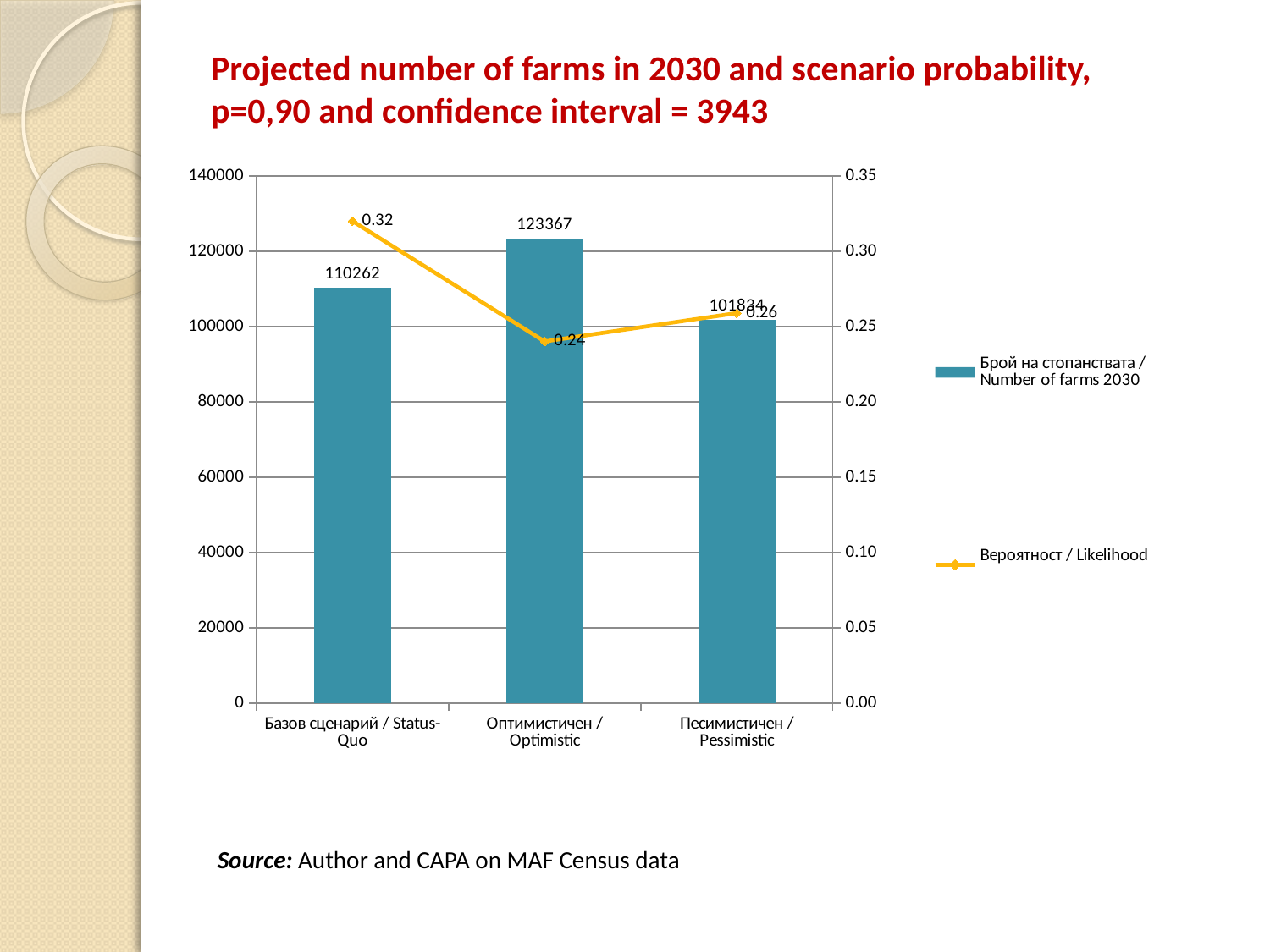
What is the difference in projected number of farms between the Optimistic and Status-Quo scenarios? 13105 What is the projected number of farms in 2030 for the Optimistic scenario? 123367 Which scenario has the highest projected number of farms in 2030? Оптимистичен / Optimistic What is the likelihood value for the Optimistic scenario? 0.24 Is the projected number of farms for the Pessimistic scenario greater or less than 100000? greater What is the projected number of farms in 2030 for the Status-Quo scenario? 110262 What is the likelihood value for the Status-Quo scenario? 0.32 Which scenario has the lowest likelihood value? Оптимистичен / Optimistic What is the difference in likelihood between the Status-Quo and Optimistic scenarios? 0.08 What is the likelihood value for the Pessimistic scenario? 0.26 How many scenarios are shown on the x axis? 3 How many series does the legend list? 2